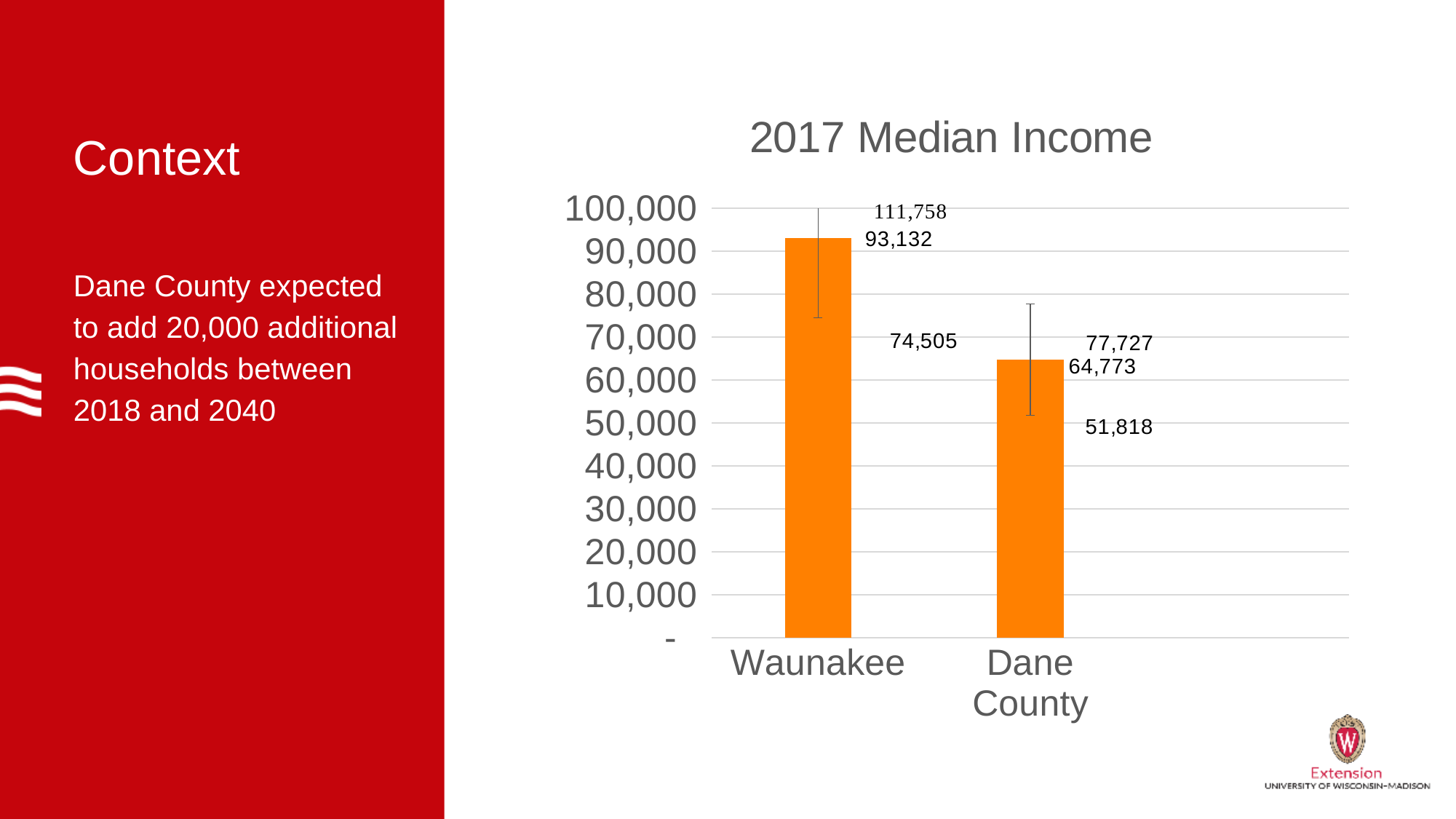
What is the difference between the Waunakee and Dane County median income values? 28,359 Which category has the lower median income in the chart? Dane County What kind of chart is shown on the slide? bar chart What is the title of the chart? 2017 Median Income What is the upper error-bar label shown for Waunakee? 111,758 Is the value for Waunakee greater or less than 90,000? greater How many categories are plotted in the chart? 2 What is the 2017 median income shown for Dane County? 64,773 Which category has the higher median income in the chart? Waunakee What is the 2017 median income shown for Waunakee? 93,132 Is the value for Dane County greater or less than 70,000? less Is the median income for Waunakee larger or smaller than that for Dane County? larger